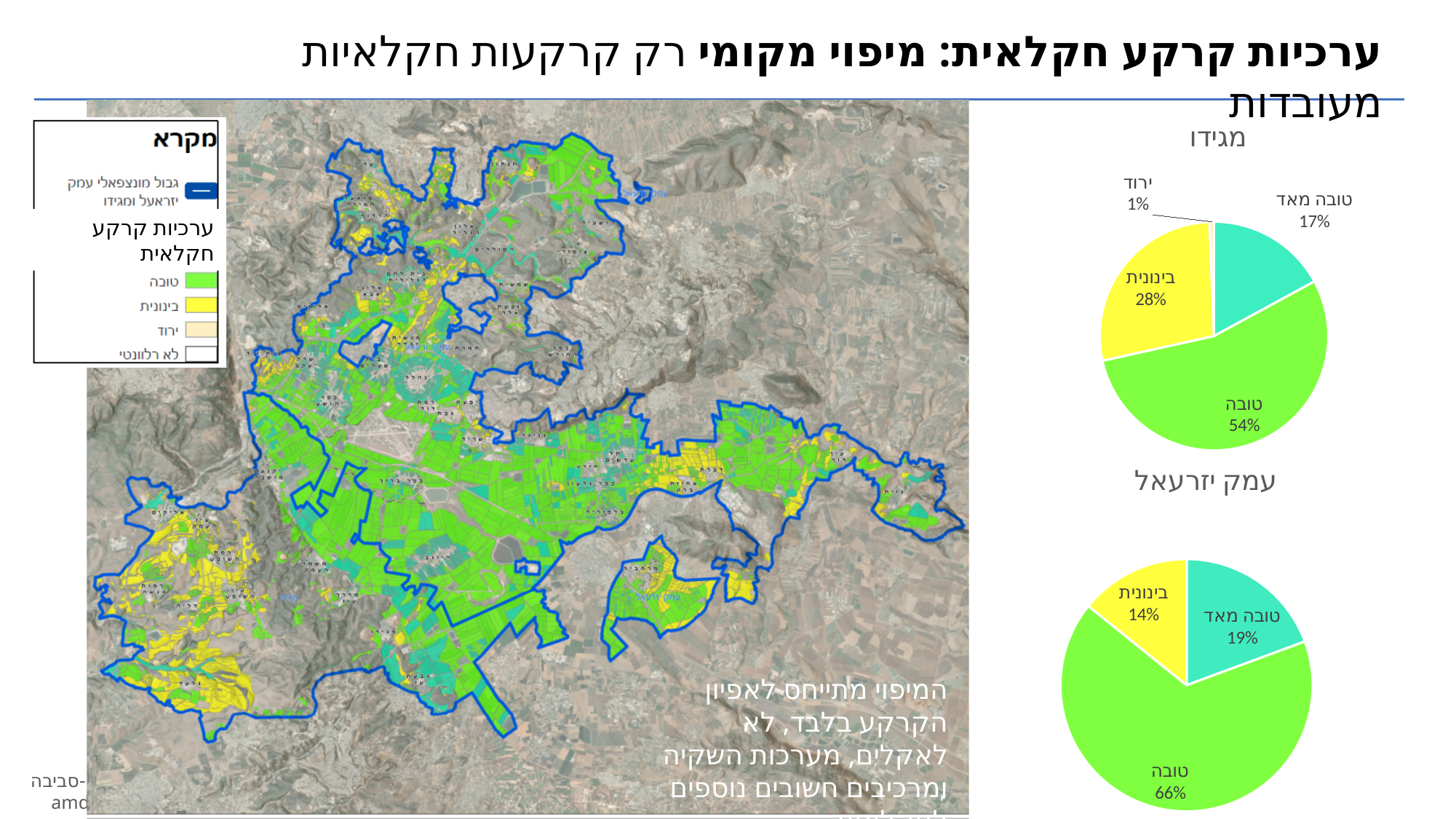
In the עמק יזרעאל pie chart, what is the difference in percentage points between טובה and טובה מאד? 47 In the עמק יזרעאל pie chart, which category has the smallest slice? בינונית What type of chart is the עמק יזרעאל chart? pie chart In the מגידו pie chart, what percentage is labelled טובה? 54% Which is larger: the בינונית share in the מגידו chart or the בינונית share in the עמק יזרעאל chart? מגידו In the מגידו pie chart, which category has the smallest slice? ירוד In the מגידו pie chart, what is the difference in percentage points between טובה and בינונית? 26 How many slices does the מגידו pie chart have? 4 In the עמק יזרעאל pie chart, what percentage is labelled בינונית? 14% In the מגידו pie chart, what percentage is labelled ירוד? 1% In the מגידו pie chart, which category has the largest slice? טובה In the עמק יזרעאל pie chart, what percentage is labelled טובה מאד? 19%